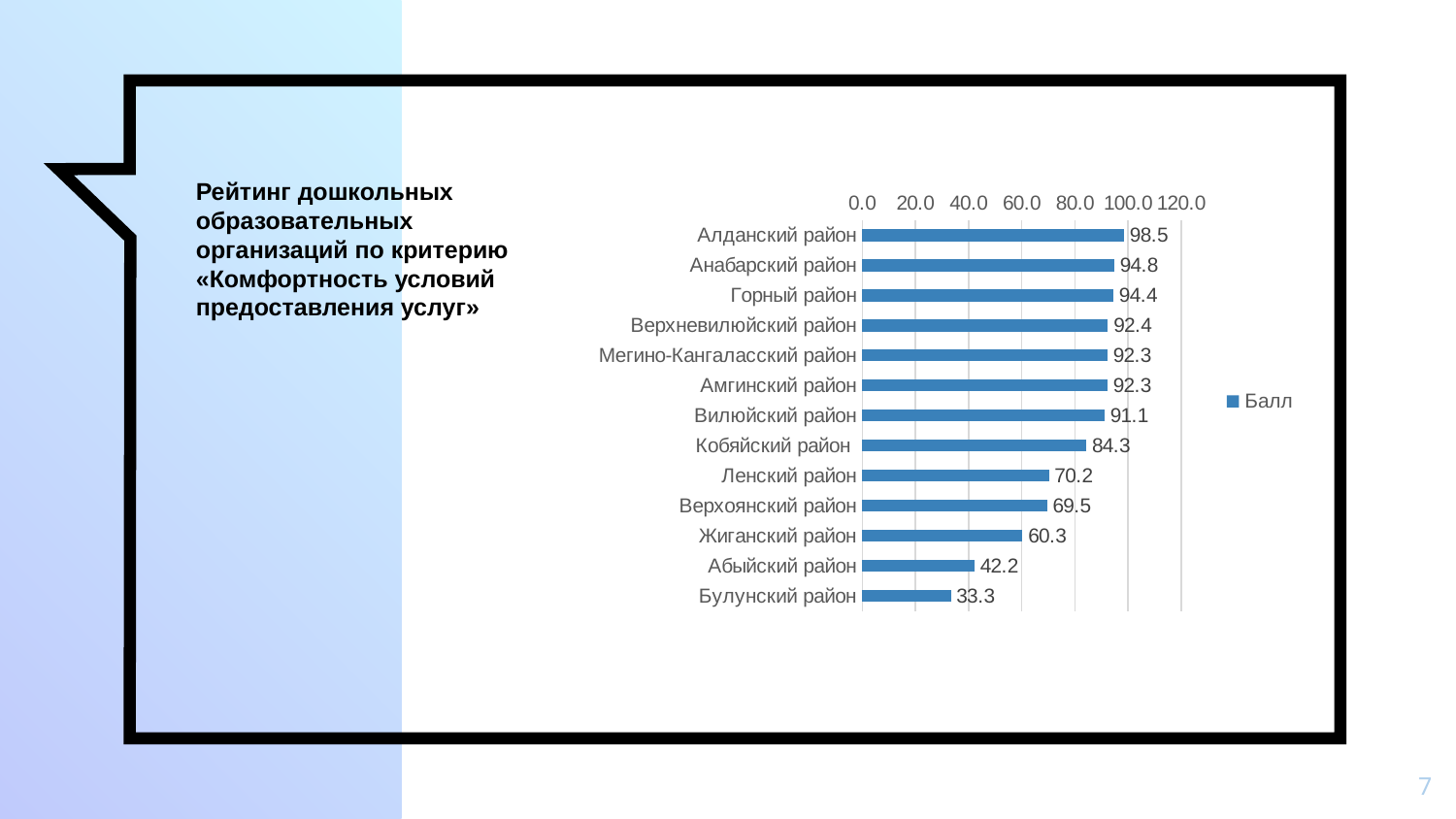
How many series does the legend list? 1 What is the value for Алданский район? 98.5 How many districts are shown in the chart? 13 What is the difference between the values for Алданский район and Булунский район? 65.2 What is the value for Кобяйский район? 84.3 What is the value for Булунский район? 33.3 Which district has the highest value? Алданский район Which district has the lowest value? Булунский район Which is larger, the value for Жиганский район or the value for Абыйский район? Жиганский район What kind of chart is shown on the slide? Bar chart Is the value for Кобяйский район greater or less than 80.0? greater What is the difference between the values for Ленский район and Верхоянский район? 0.7